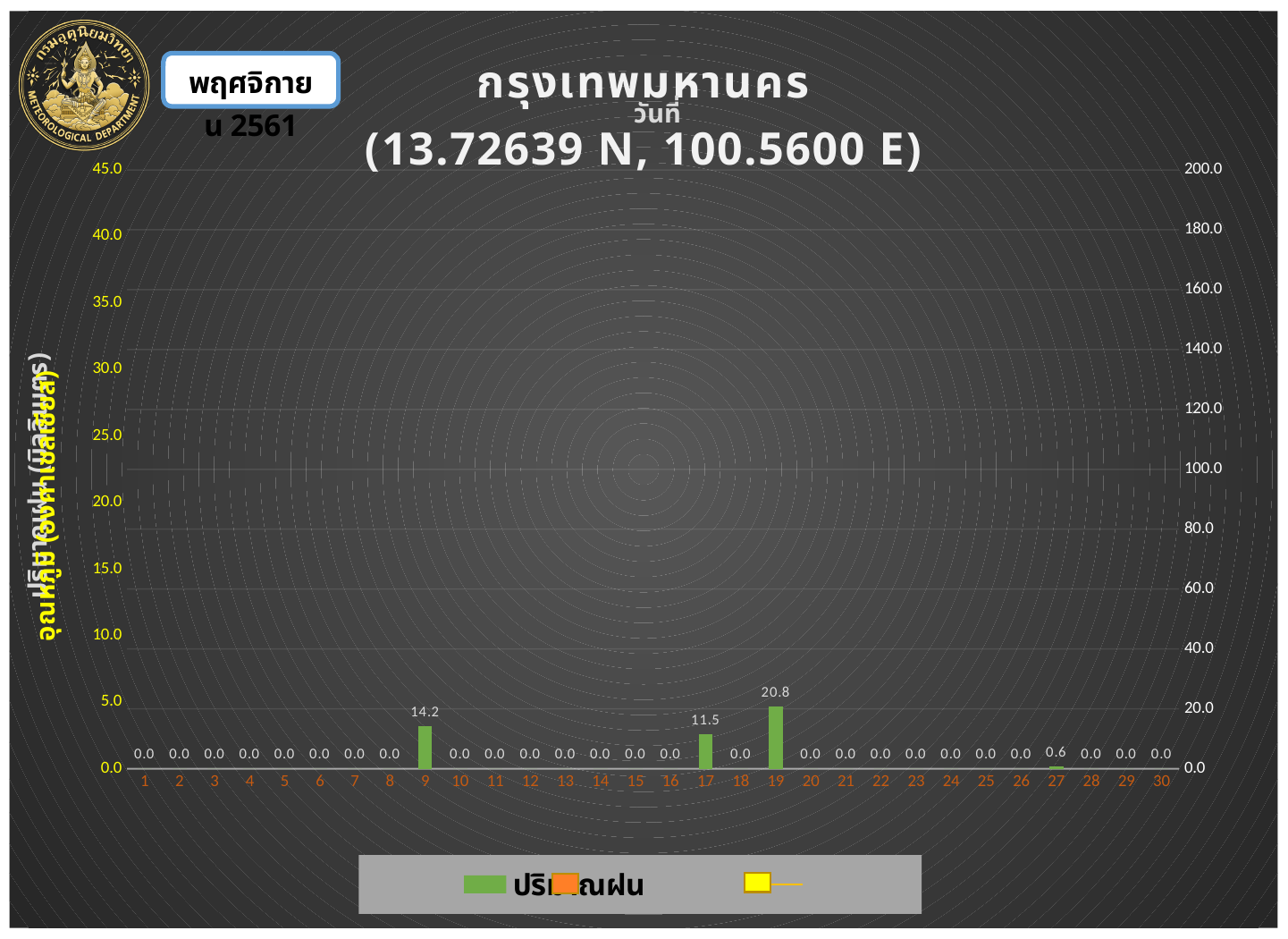
Which is larger, the rainfall value for day 9 or for day 17? day 9 What is the difference between the rainfall values for day 19 and day 9? 6.6 What kind of chart is shown on the slide? bar chart How many days are shown on the x axis? 30 What is the rainfall value for day 27? 0.6 What is the difference between the rainfall values for day 9 and day 17? 2.7 What is the rainfall value for day 17? 11.5 What are the coordinates given in the chart title? 13.72639 N, 100.5600 E What is the rainfall value for day 5? 0.0 What is the rainfall value for day 19? 20.8 Which day has the highest rainfall value? 19 What is the rainfall value for day 9? 14.2